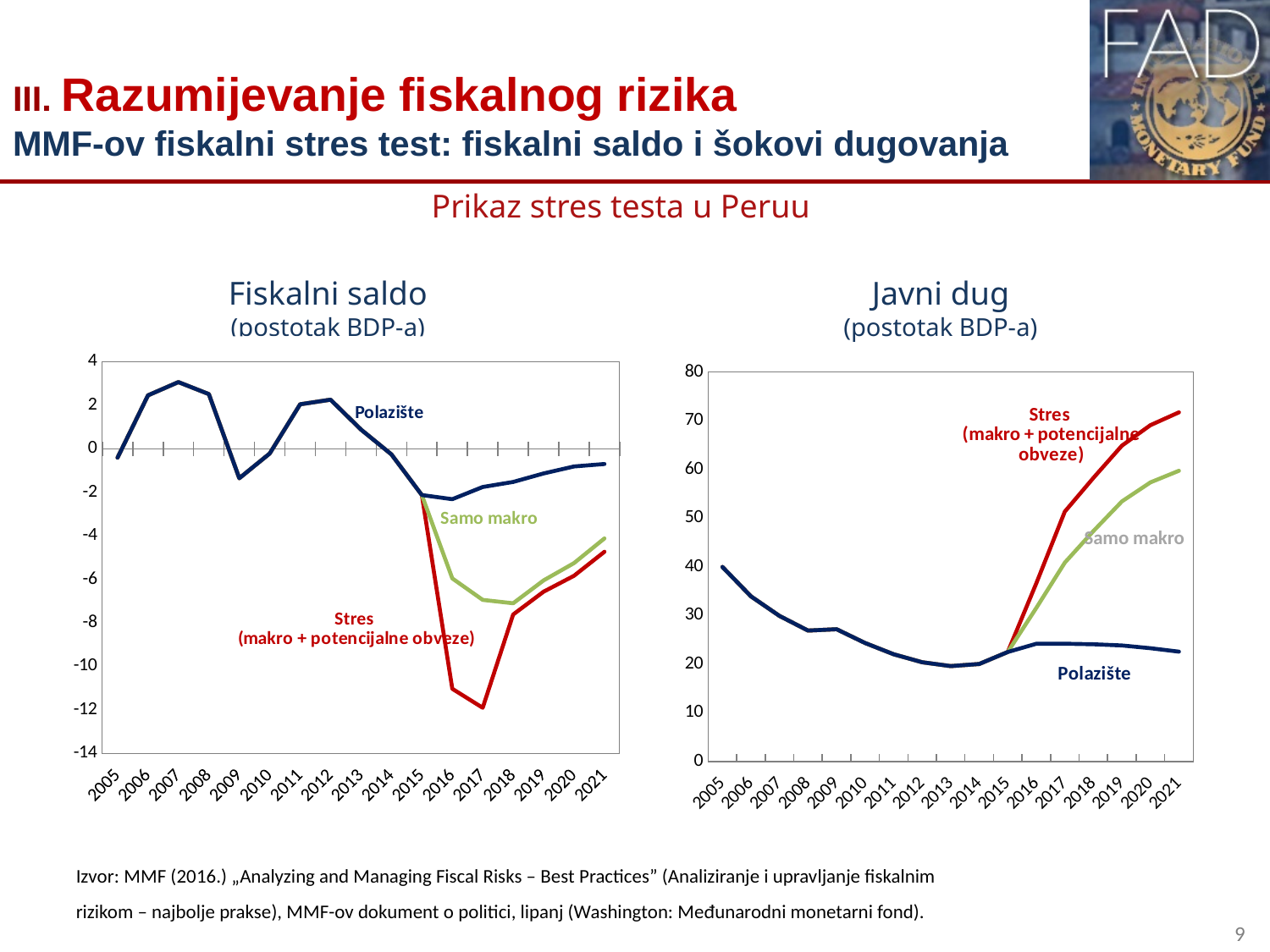
In the "Javni dug" chart, is the value of the Stres (makro + potencijalne obveze) line in 2021 greater or less than 60? greater In the "Fiskalni saldo" chart, is the value of the Polazište line in 2007 greater or less than 2? greater What kind of chart is the "Fiskalni saldo" chart on the left? line chart In the "Fiskalni saldo" chart, is the value of the Samo makro line in 2018 greater or less than -6? less What unit is given in the subtitle of both charts? postotak BDP-a In the "Javni dug" chart, does the Polazište line rise or fall from 2005 to 2013? fall In the "Fiskalni saldo" chart, in which year does the Polazište line reach its highest value? 2007 How many years are shown on the x axis of the "Javni dug" chart? 17 In the "Javni dug" chart, which line is higher in 2021: Stres (makro + potencijalne obveze) or Samo makro? Stres (makro + potencijalne obveze) In the "Fiskalni saldo" chart, which line is higher in 2017: Polazište or Stres (makro + potencijalne obveze)? Polazište